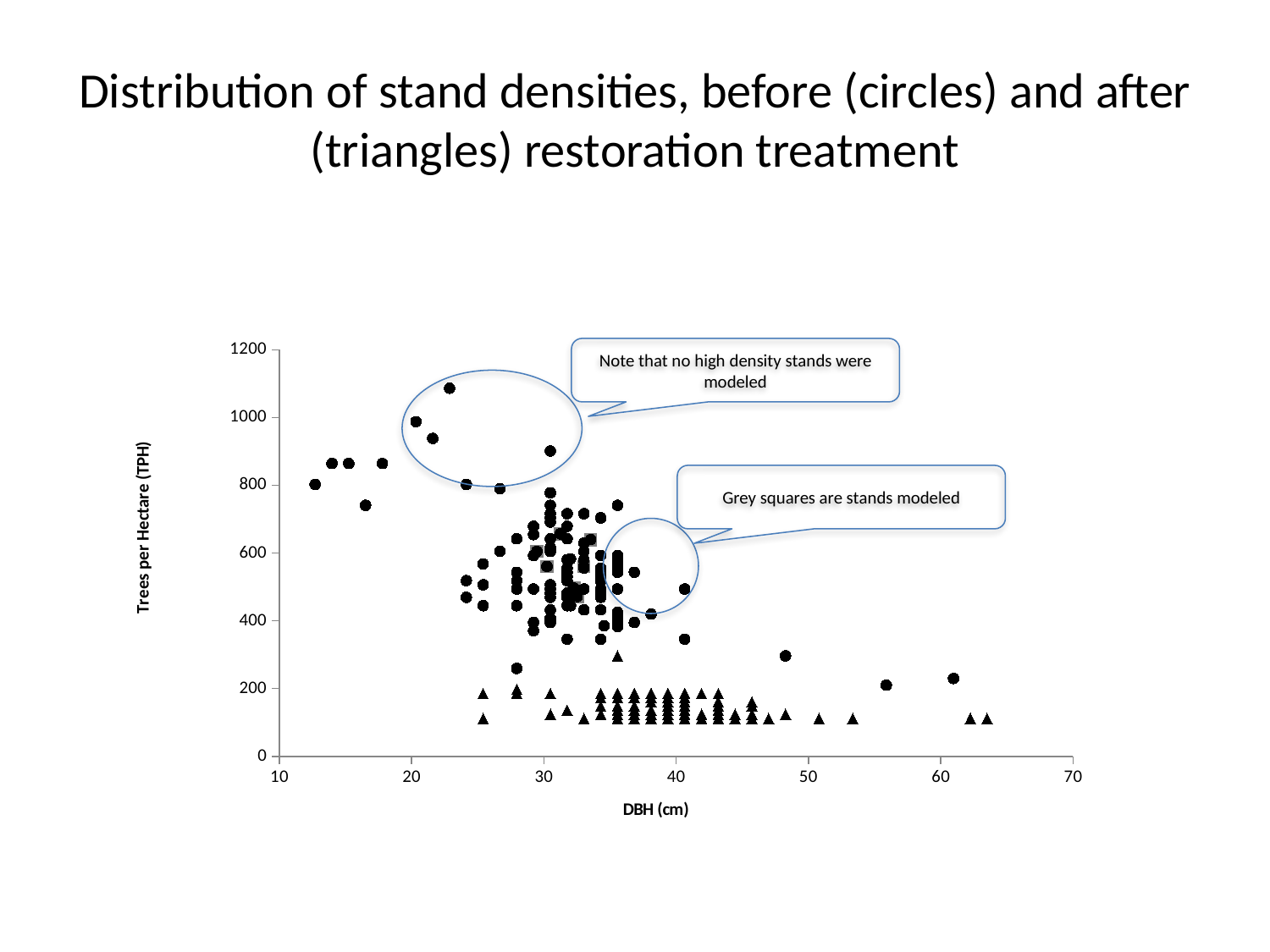
Is the value for the leftmost circle, at a DBH of about 12 cm, greater or less than 600 trees per hectare? greater What is the label of the x axis? DBH (cm) Do the circle (before treatment) values generally rise or fall as DBH increases? fall Is the highest circle (before treatment) value greater or less than 1000 trees per hectare? greater What kind of chart is shown on the slide? scatter chart Are the triangle (after treatment) values greater or less than 400 trees per hectare? less What is the label of the y axis? Trees per Hectare (TPH) What is the maximum value shown on the y axis? 1200 Which marker type shows higher trees per hectare overall, circles or triangles? circles